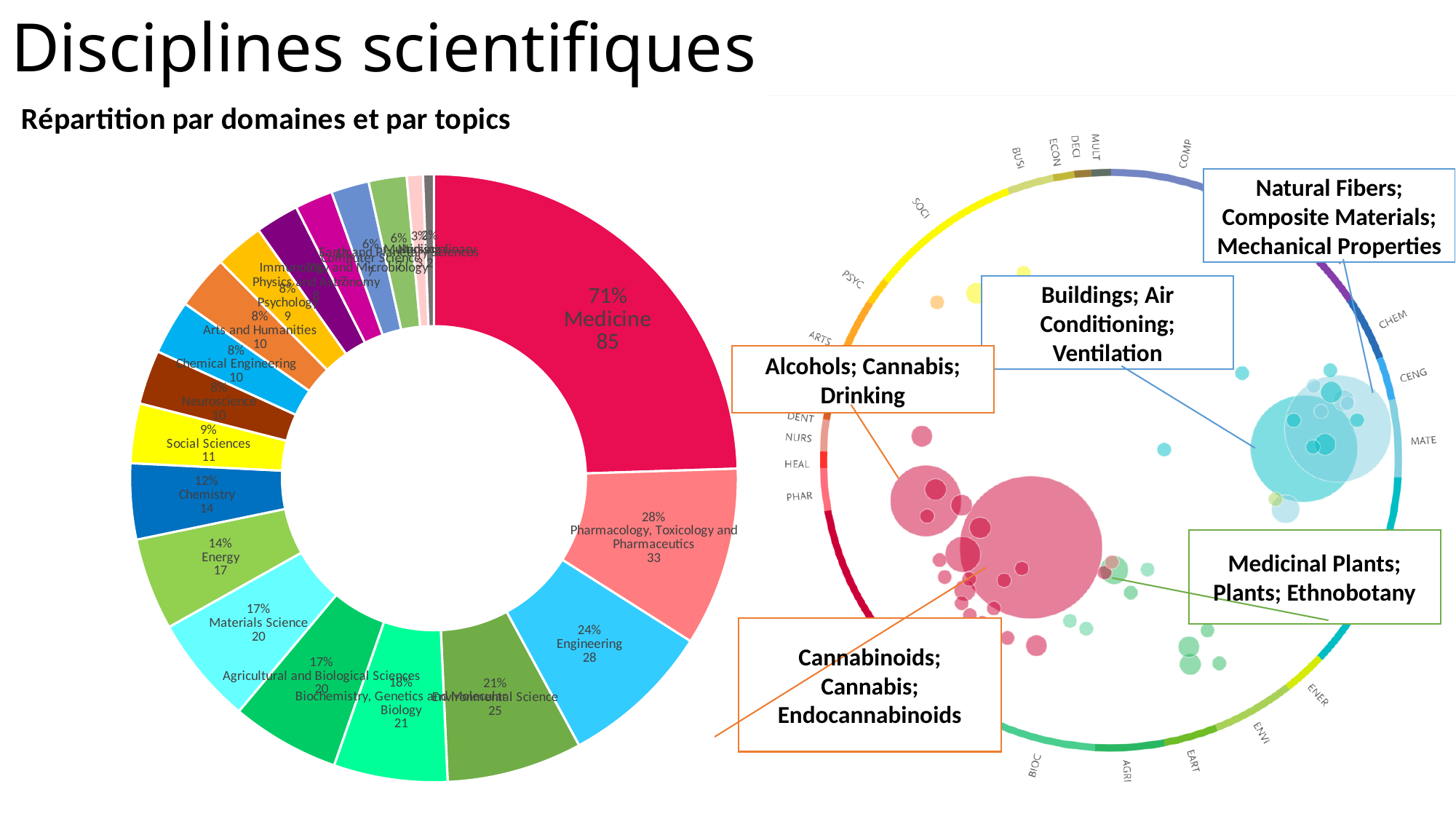
On the donut chart on the left, what is the count shown for Environmental Science? 25 What is the subtitle written above the donut chart on the left? Répartition par domaines et par topics On the donut chart on the left, what percentage is shown for Materials Science? 17% On the donut chart on the left, what is the count shown for Social Sciences? 11 On the donut chart on the left, what percentage is shown for Engineering? 24% On the donut chart on the left, what percentage is shown for Medicine? 71% On the donut chart on the left, what kind of chart is it? Donut (pie) chart On the donut chart on the left, which has a larger count, Chemistry or Energy? Energy On the donut chart on the left, which discipline has the largest slice? Medicine On the donut chart on the left, what is the count shown for Medicine? 85 On the donut chart on the left, what is the count shown for Pharmacology, Toxicology and Pharmaceutics? 33 On the donut chart on the left, what is the difference between the counts for Medicine and Engineering? 57